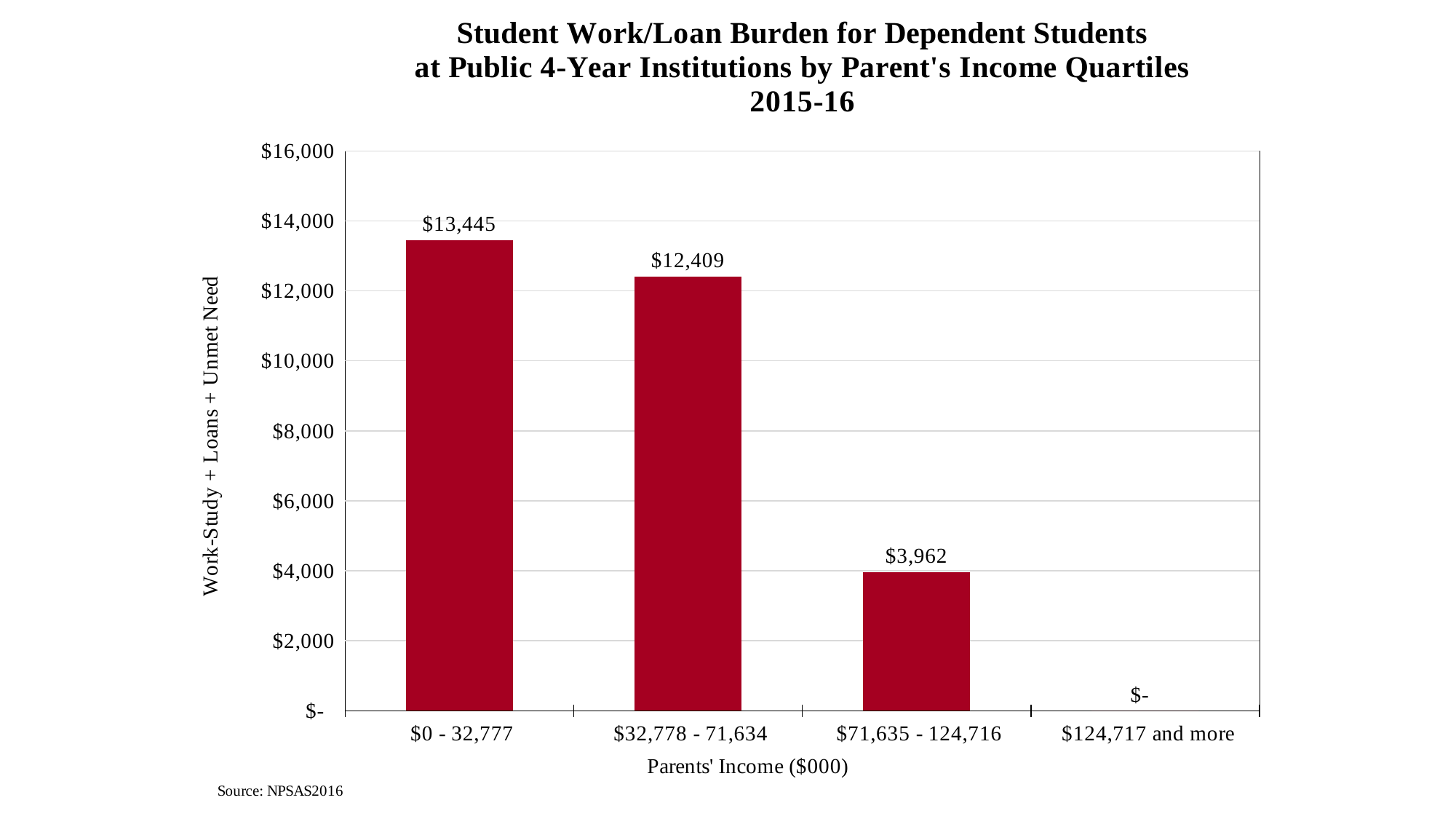
How many parents' income quartiles are shown on the x axis? 4 What kind of chart is shown on the slide? Bar chart What is the difference between the values for the $0 - 32,777 and $32,778 - 71,634 quartiles? $1,036 Which parents' income quartile has the lowest work/loan burden? $124,717 and more Do the values rise or fall as parents' income increases along the x axis? Fall Which parents' income quartile has the highest work/loan burden? $0 - 32,777 What is the value shown for the $124,717 and more income quartile? $- What is the value shown for the $71,635 - 124,716 income quartile? $3,962 What is the value shown for the $32,778 - 71,634 income quartile? $12,409 What is the student work/loan burden for the $0 - 32,777 parents' income quartile? $13,445 Which is larger, the value for $32,778 - 71,634 or the value for $71,635 - 124,716? $32,778 - 71,634 What is the difference between the values for the $32,778 - 71,634 and $71,635 - 124,716 quartiles? $8,447